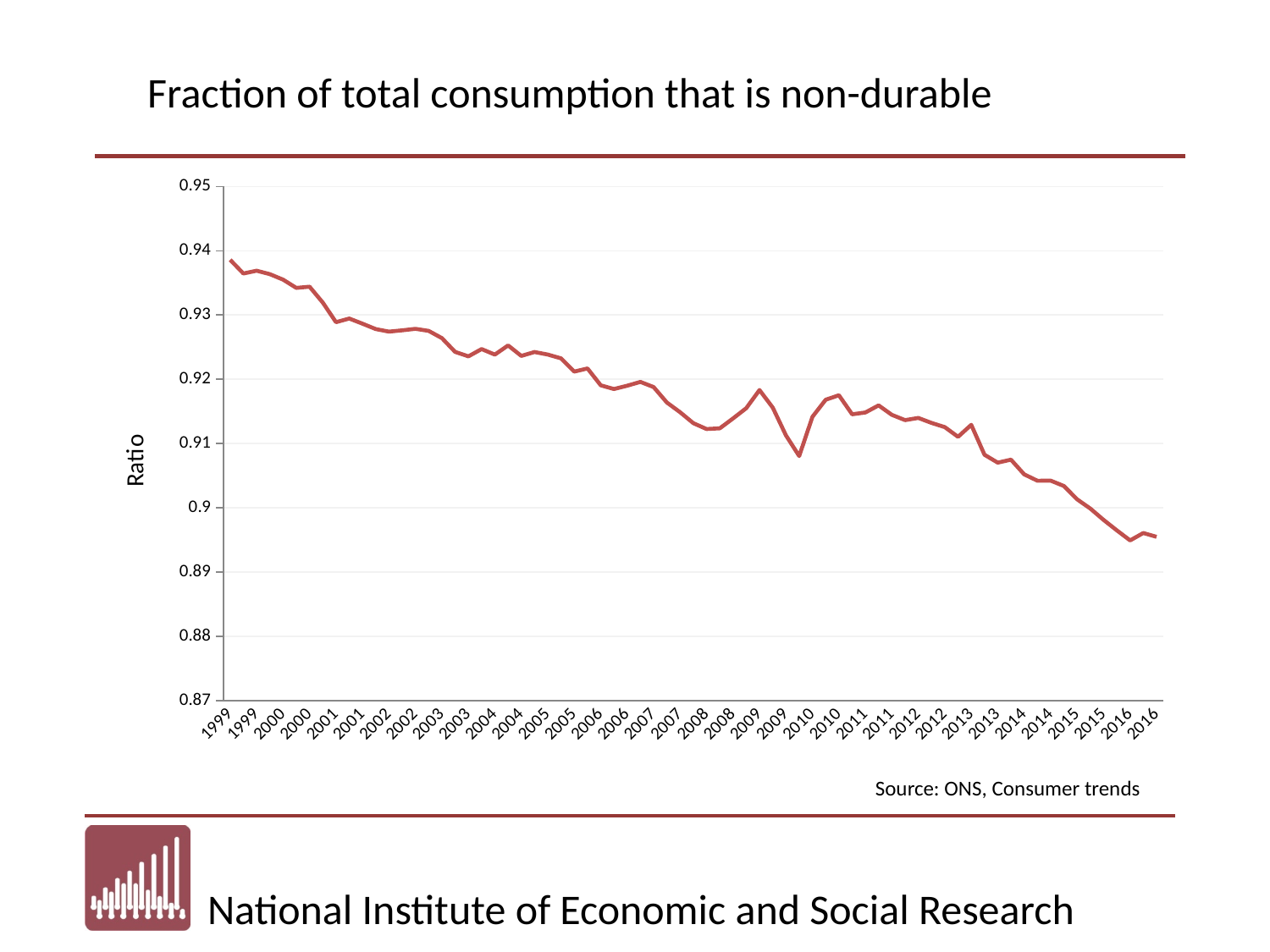
Is the value in 2014 greater or less than 0.91? less Is the value in 2005 greater or less than 0.92? greater In which year is the ratio at its lowest? 2016 What is the title of the chart? Fraction of total consumption that is non-durable Is the value in 2008 greater or less than 0.92? less Is the ratio in 1999 larger or smaller than the ratio in 2016? Larger Overall, does the ratio rise or fall from 1999 to 2016? Fall In which year is the ratio at its highest? 1999 What kind of chart is shown on the slide? Line chart What is the label on the vertical axis of the chart? Ratio